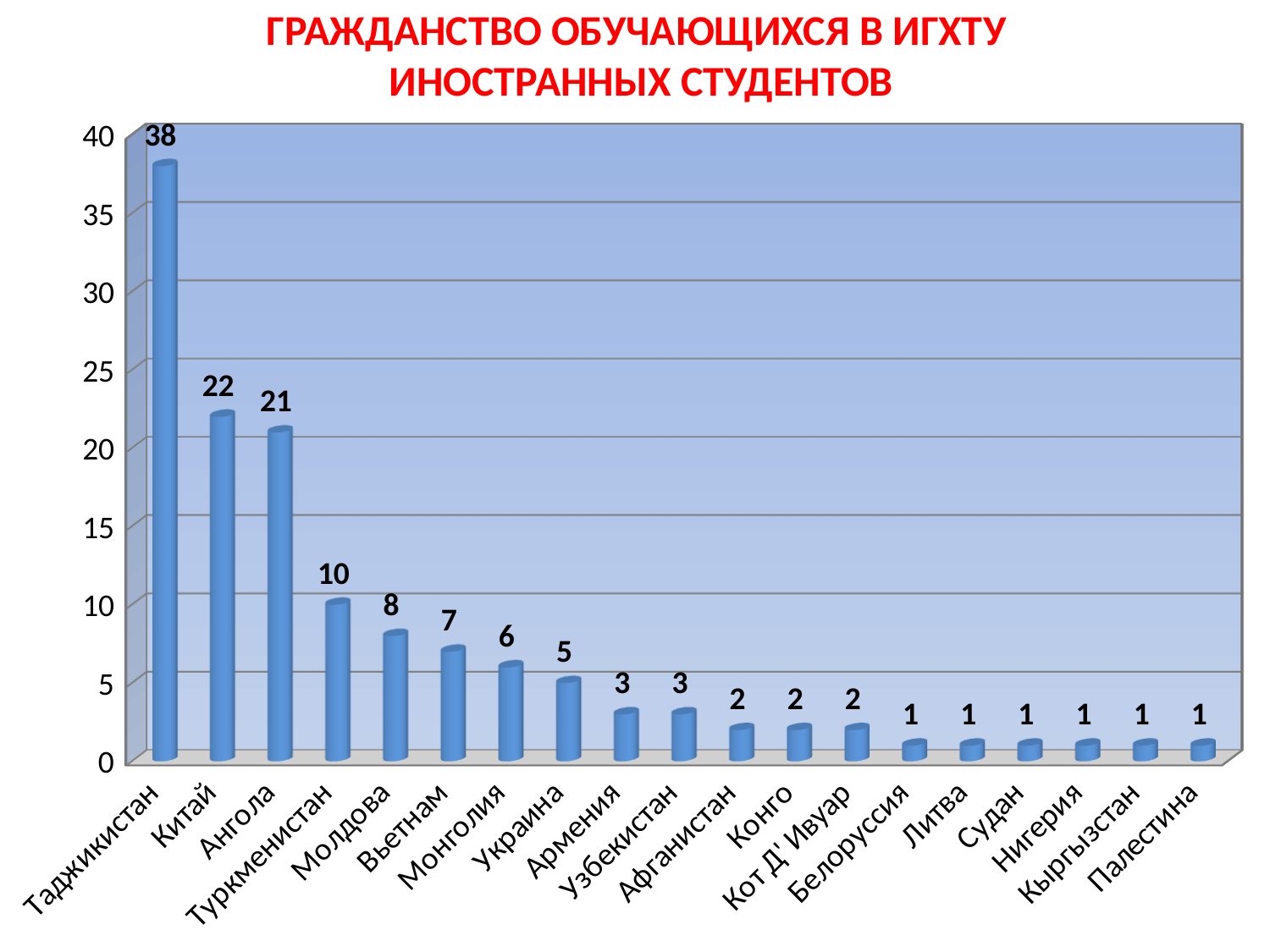
What is the value for Монголия? 6 What is the value for Китай? 22 What kind of chart is shown on the slide? bar chart What is the difference between the values for Китай and Ангола? 1 Is the value for Ангола greater or less than 20? greater Do the values rise or fall from left to right along the x axis? fall Which is larger, the value for Молдова or the value for Вьетнам? Молдова What is the difference between the values for Таджикистан and Туркменистан? 28 What is the value for Туркменистан? 10 What is the value for Таджикистан? 38 Which country has the highest value? Таджикистан How many countries are shown on the x axis? 19